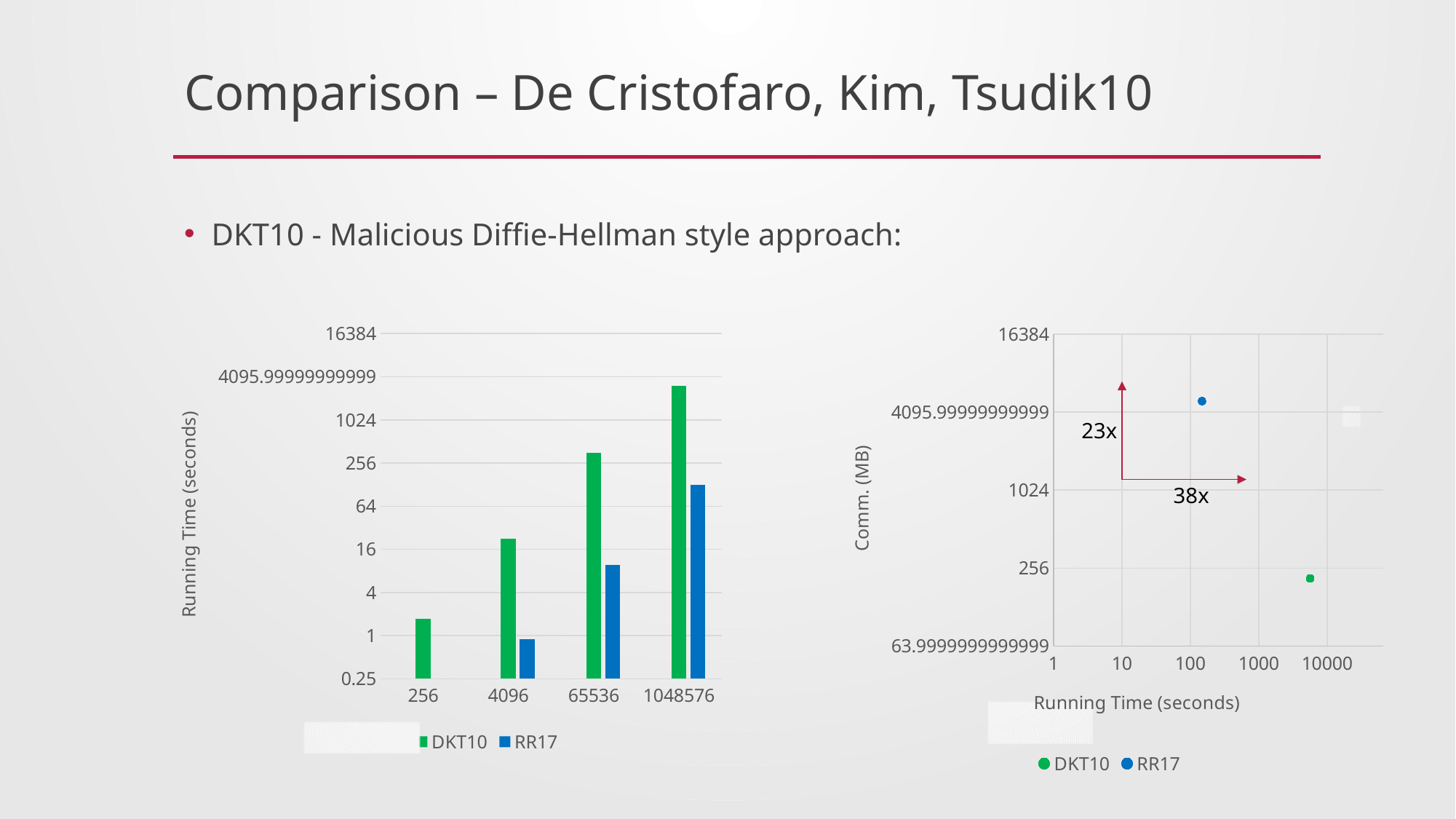
In the left bar chart, do the DKT10 running times rise or fall as the category size increases along the x axis? rise In the left bar chart, at category 65536, which series has the larger running time, DKT10 or RR17? DKT10 In the left bar chart, for which category is the DKT10 running time highest? 1048576 In the right scatter chart, is the running time of the DKT10 point greater or less than 1000 seconds? greater In the left bar chart, is the DKT10 value for 1048576 greater or less than 1024? greater What is the x-axis label of the right scatter chart? Running Time (seconds) In the left bar chart, how many categories are shown on the x axis? 4 What kind of chart is the left chart showing Running Time (seconds)? bar chart In the left bar chart, how many series does the legend list? 2 What kind of chart is the right chart showing Comm. (MB)? scatter chart In the right scatter chart, which series has the higher Comm. (MB) value, DKT10 or RR17? RR17